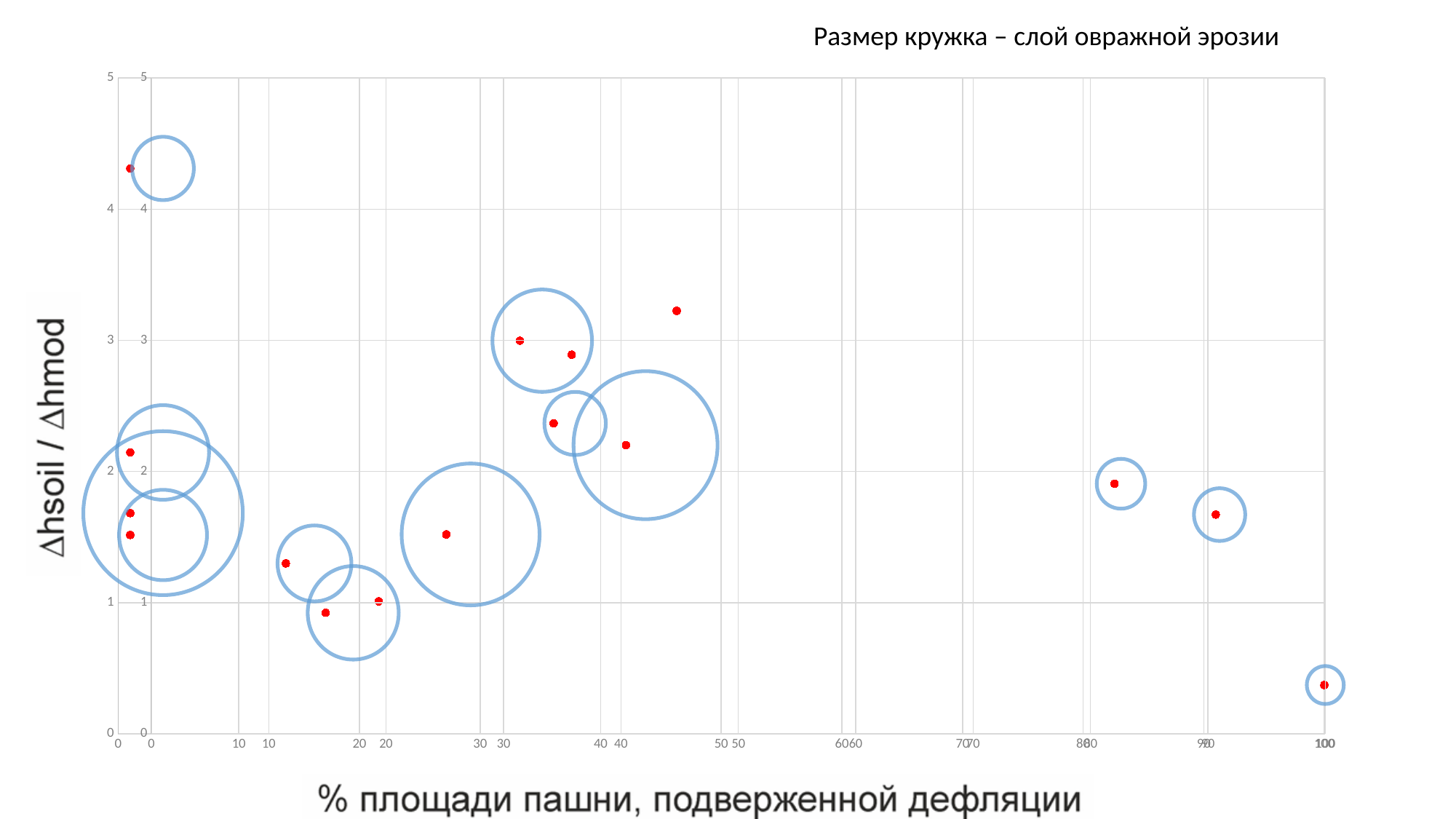
Where on the x axis is the smallest bubble located? 100 Which has the larger Δhsoil / Δhmod value: the point near 45% or the point near 91% on the x axis? the point near 45% What is the label of the horizontal axis? % площади пашни, подверженной дефляции Is the Δhsoil / Δhmod value of the highest point (near 0% on the x axis) greater or less than 4? greater Which point has the lowest Δhsoil / Δhmod value: the one at 100% or the one near 82% on the x axis? the one at 100% Is the value of Δhsoil / Δhmod for the point at 100% on the x axis greater or less than 1? less Is the Δhsoil / Δhmod value of the point near 45% on the x axis greater or less than 3? greater What is the maximum value shown on the vertical axis? 5 What kind of chart is shown on the slide? bubble chart What does the size of the bubble represent, according to the text on the slide? слой овражной эрозии